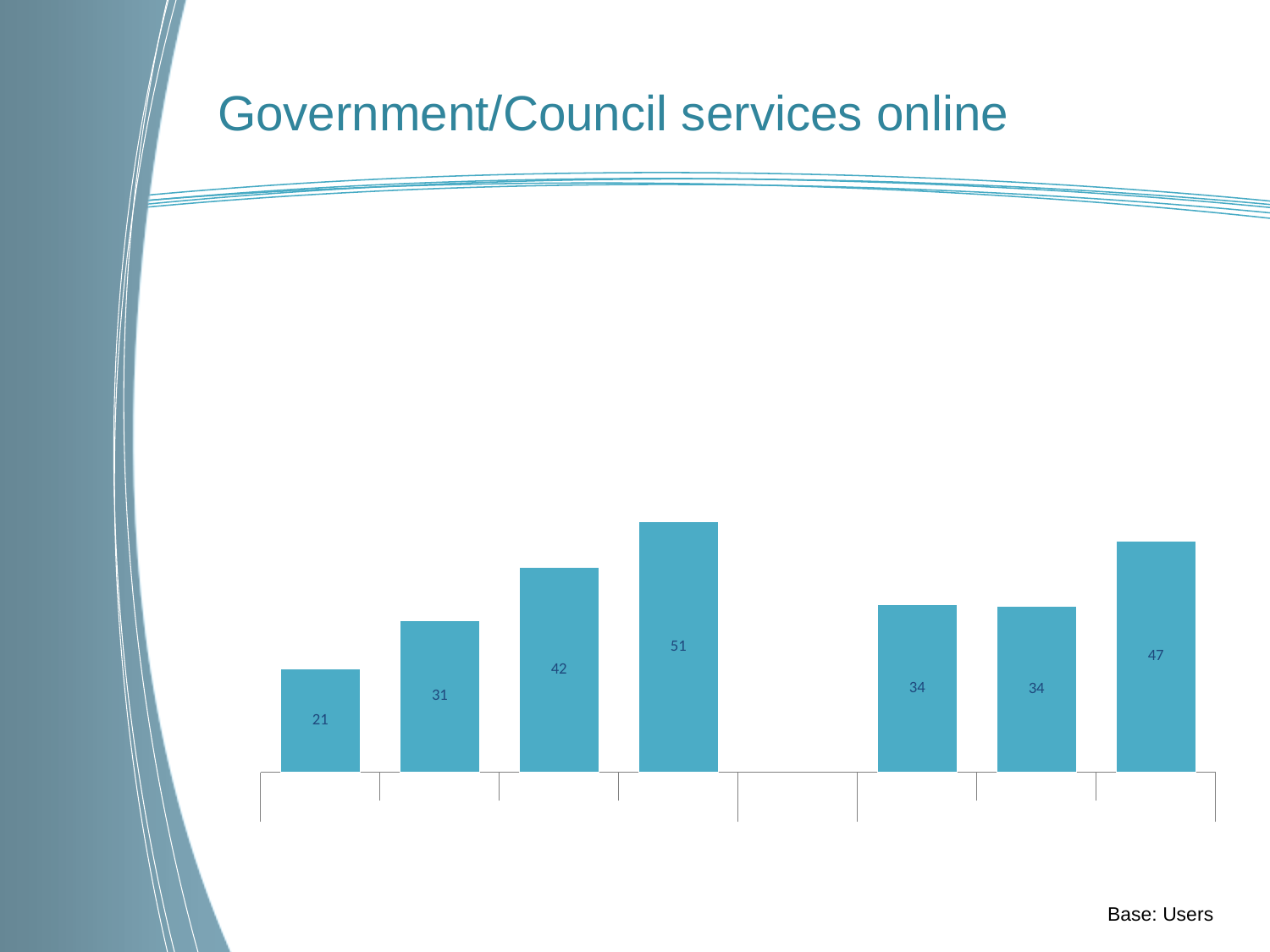
What is the lowest value labelled on any bar in the chart? 21 How many bars are plotted in the chart? 7 What is the value shown on the first (leftmost) bar? 21 What is the title of the slide containing the chart? Government/Council services online What base note is printed at the bottom right of the slide? Base: Users What is the value shown on the fourth bar from the left? 51 Do the values of the first four bars rise or fall from left to right? rise Which is larger: the value of the third bar from the left or the value of the rightmost bar? the rightmost bar (47) What is the highest value labelled on any bar in the chart? 51 What kind of chart is shown on the slide? bar chart What is the value shown on the last (rightmost) bar? 47 What is the difference between the highest bar value (51) and the lowest bar value (21)? 30